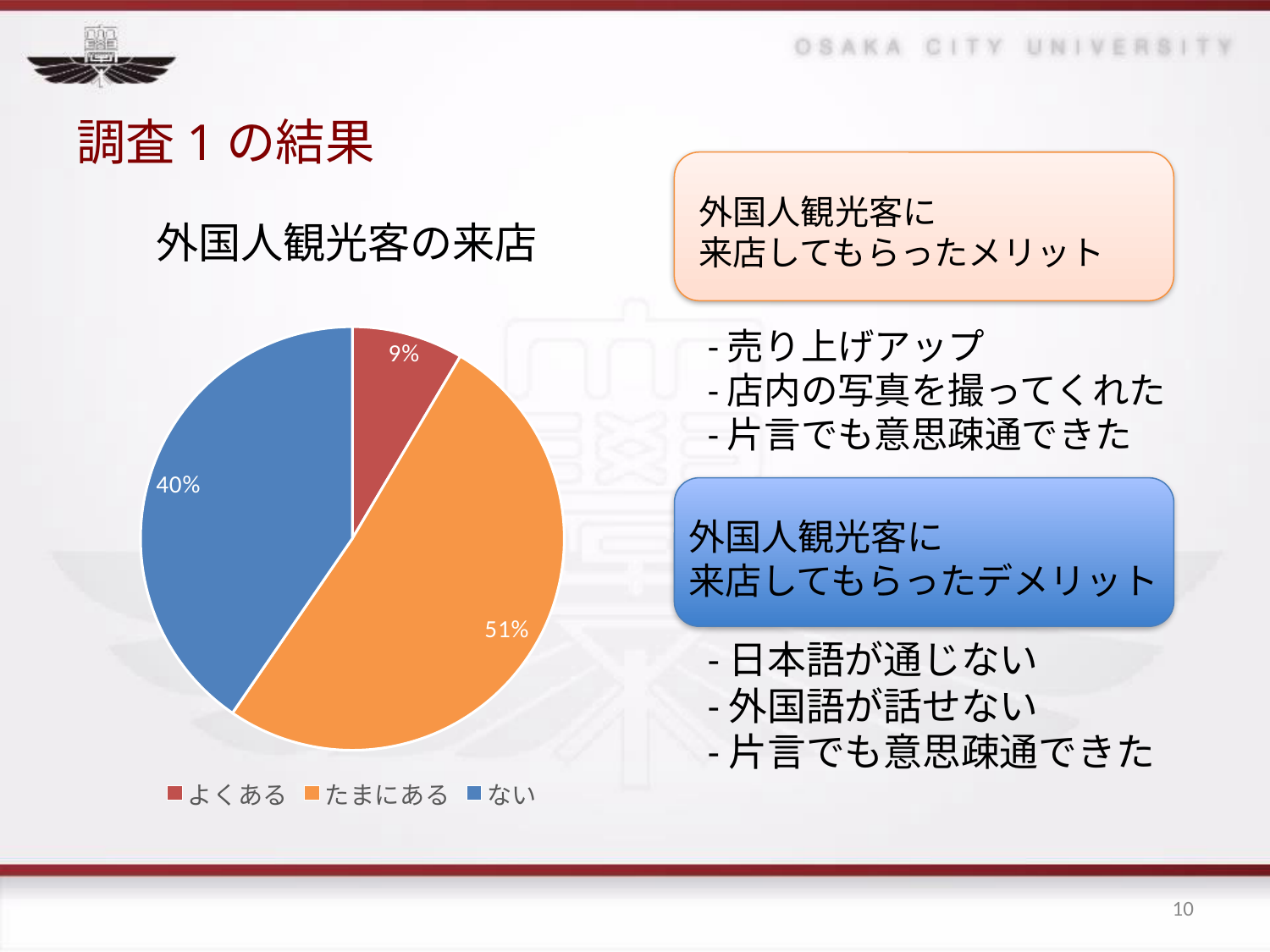
What percentage of the pie is labelled ない? 40% What is the chart's title? 外国人観光客の来店 Which category has the smallest share of the pie? よくある What is the difference in percentage points between たまにある and ない? 11 What colour is the slice for ない? blue Which is larger, the share for ない or the share for よくある? ない How many entries does the legend list? 3 What percentage of the pie is labelled たまにある? 51% Which category has the largest share of the pie? たまにある How many categories does the pie chart have? 3 What percentage of the pie is labelled よくある? 9% What type of chart is shown on the slide? pie chart